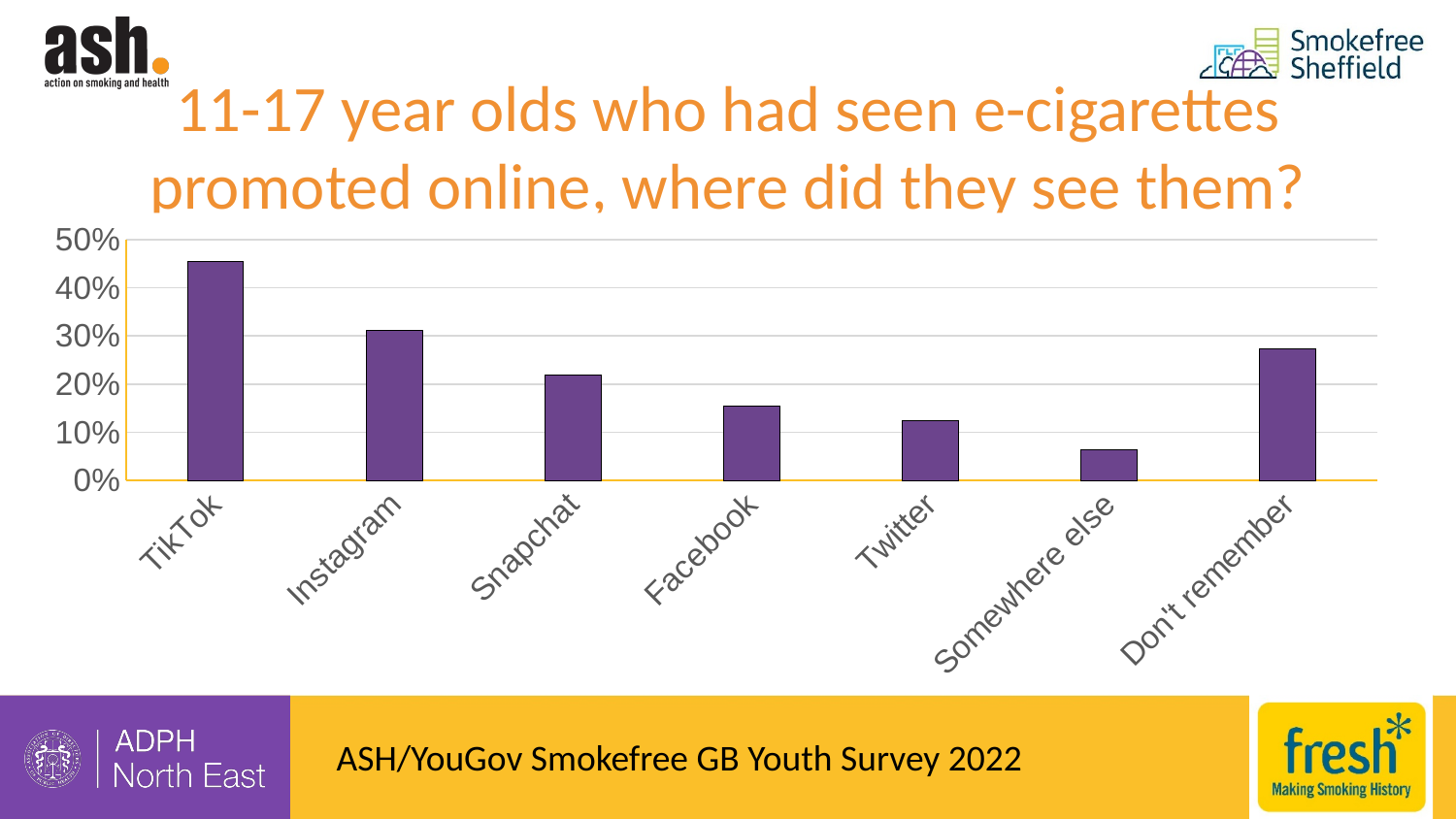
What kind of chart is shown on the slide? bar chart Is the value for TikTok greater or less than 40%? greater Is the value for Instagram greater or less than 40%? less Which category has the lowest value in the chart? Somewhere else What is the title of the chart on the slide? 11-17 year olds who had seen e-cigarettes promoted online, where did they see them? Which is larger, the value for Don't remember or the value for Snapchat? Don't remember Is the value for Snapchat greater or less than 20%? greater How many categories are shown on the x axis of the chart? 7 Which is larger, the value for Facebook or the value for Twitter? Facebook Which category has the highest value in the chart? TikTok